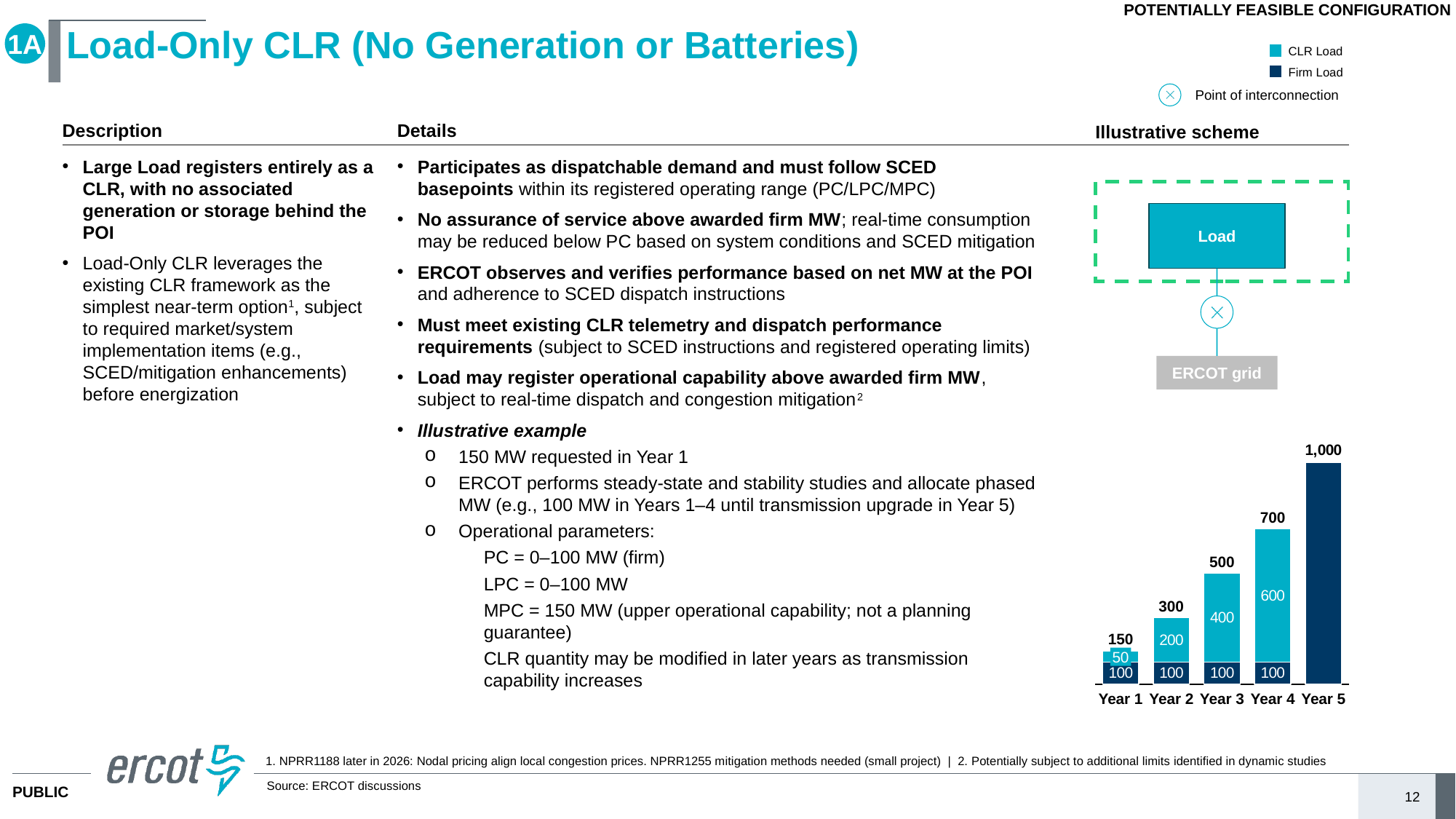
What is the Firm Load value for Year 4? 100 What is the difference between the total for Year 4 and the total for Year 2? 400 How many series does the legend list? 2 What kind of chart is shown at the bottom right of the slide? Stacked bar chart Which is larger, the CLR Load value for Year 3 or the CLR Load value for Year 1? Year 3 What is the CLR Load value for Year 2? 200 Which year has the lowest total value? Year 1 How many years are shown on the x axis of the bar chart? 5 What is the total value shown above the bar for Year 3? 500 What is the value shown for Year 5? 1,000 Which year has the highest total value? Year 5 Do the total values rise or fall from Year 1 to Year 5? Rise